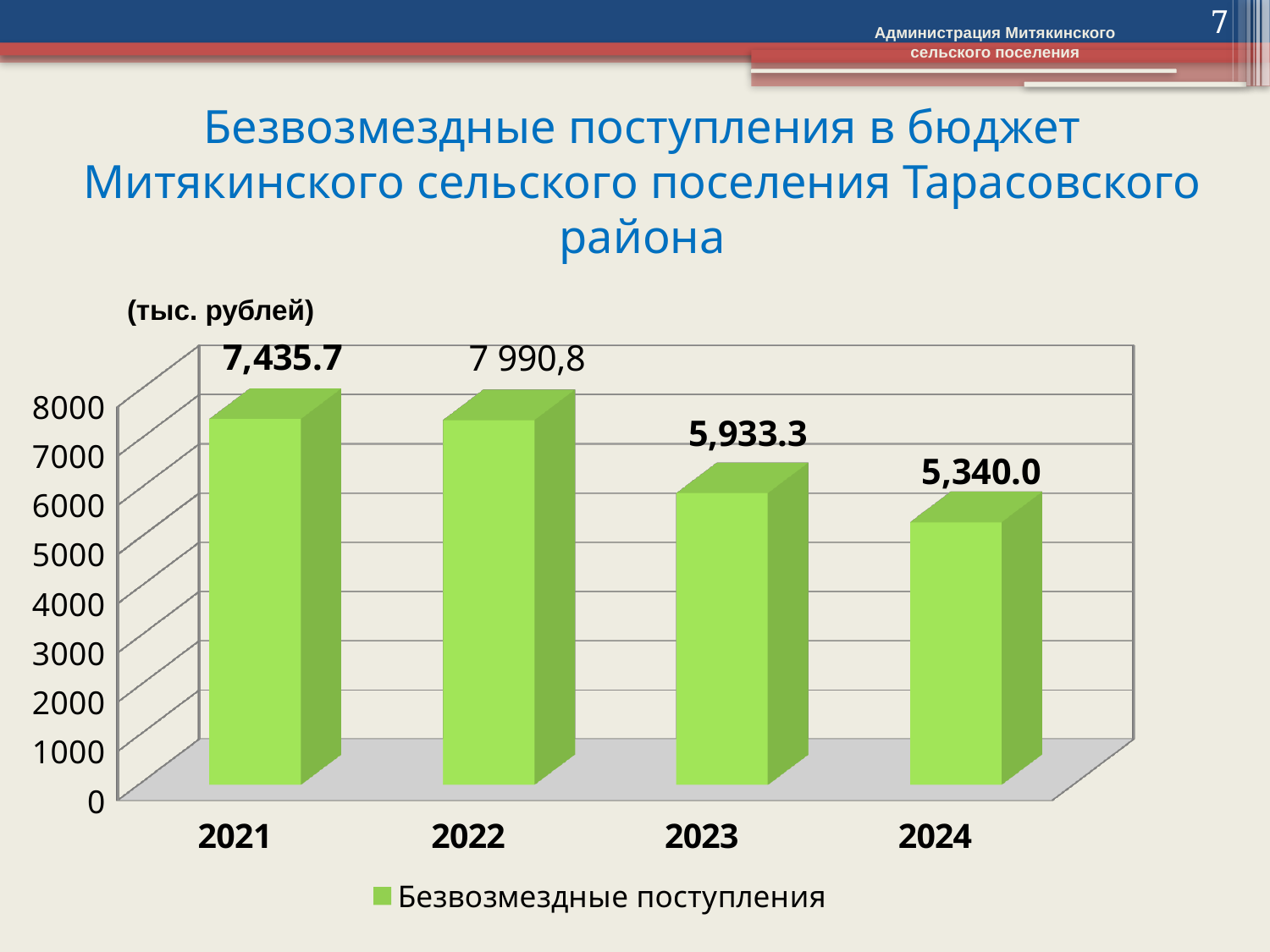
How many years are shown on the x axis? 4 Which year has the lowest value? 2024 What is the value for 2021? 7,435.7 What is the difference between the values for 2023 and 2024? 593.3 From 2022 to 2024, do the values rise or fall? fall What is the value for 2024? 5,340.0 What is the value shown for 2022? 7 990,8 What is the value for 2023? 5,933.3 Is the value for 2024 greater or less than 6000? less What is the difference between the values for 2021 and 2023? 1,502.4 What kind of chart is shown? bar chart Which is larger, the value for 2021 or the value for 2024? 2021